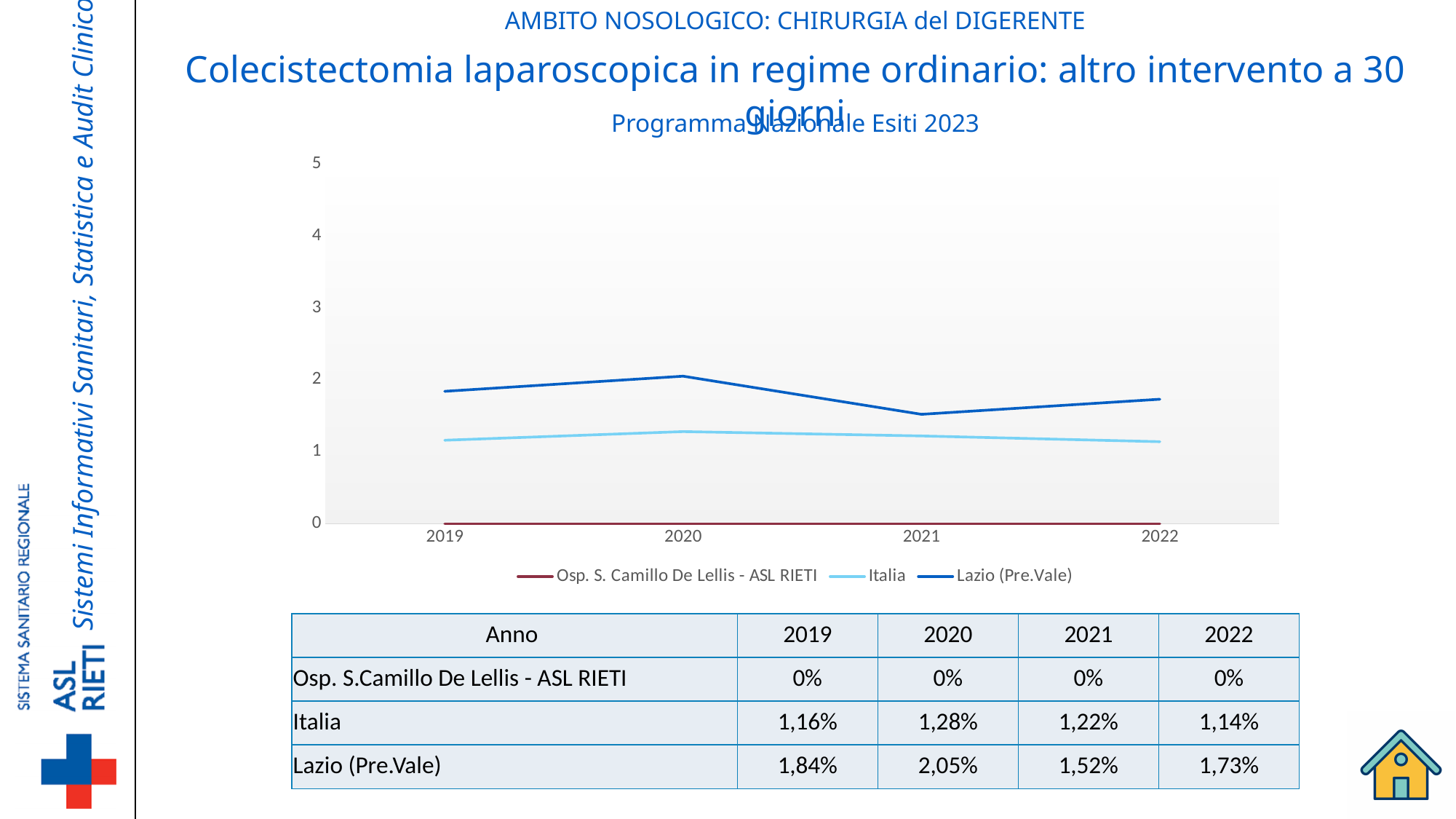
In which year is the Lazio (Pre.Vale) value highest? 2020 Is the value for Lazio (Pre.Vale) in 2020 greater or less than 2? greater Which series has the larger value in 2021, Italia or Lazio (Pre.Vale)? Lazio (Pre.Vale) What is the difference between the Lazio (Pre.Vale) and Italia values in 2019? 0,68% What is the value for Italia in 2022? 1,14% In which year is the Lazio (Pre.Vale) value lowest? 2021 What is the value for Lazio (Pre.Vale) in 2020? 2,05% How many years are plotted along the x axis of the chart? 4 Does the Italia series rise or fall from 2020 to 2022? fall How many series does the chart legend list? 3 What is the value for Osp. S.Camillo De Lellis - ASL RIETI in 2021? 0% What kind of chart is shown on the slide? line chart